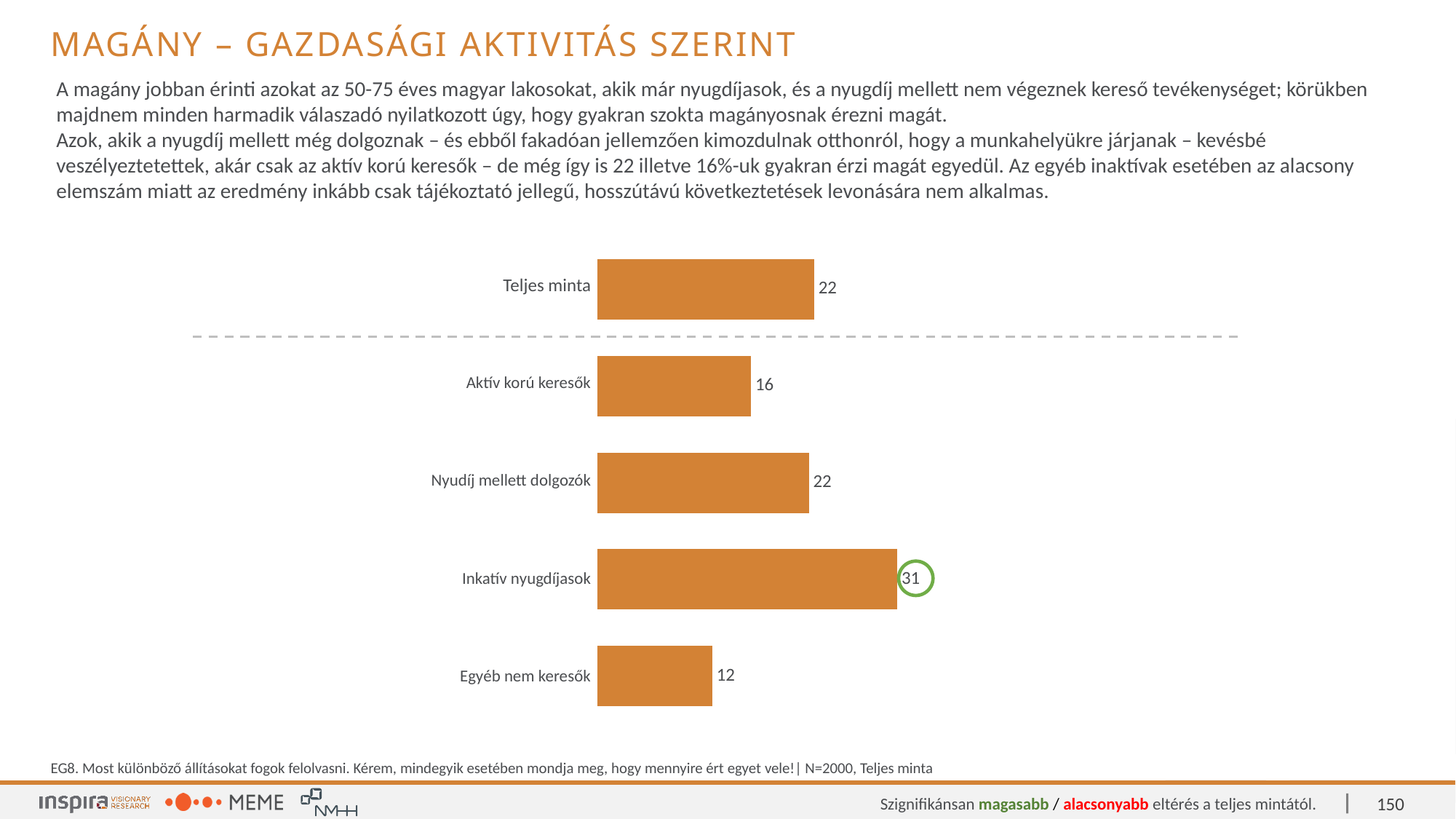
What is the value for Inkatív nyugdíjasok? 31 Which category's data label is circled in green? Inkatív nyugdíjasok Which is larger, the value for Nyudíj mellett dolgozók or the value for Aktív korú keresők? Nyudíj mellett dolgozók What is the value for Egyéb nem keresők? 12 What is the value for Aktív korú keresők? 16 What is the difference between the values for Inkatív nyugdíjasok and Teljes minta? 9 Which category has the highest value? Inkatív nyugdíjasok How many categories are shown in the chart? 5 What is the difference between the values for Aktív korú keresők and Egyéb nem keresők? 4 Which category has the lowest value? Egyéb nem keresők What is the value for Teljes minta? 22 What kind of chart is shown on the slide? Bar chart